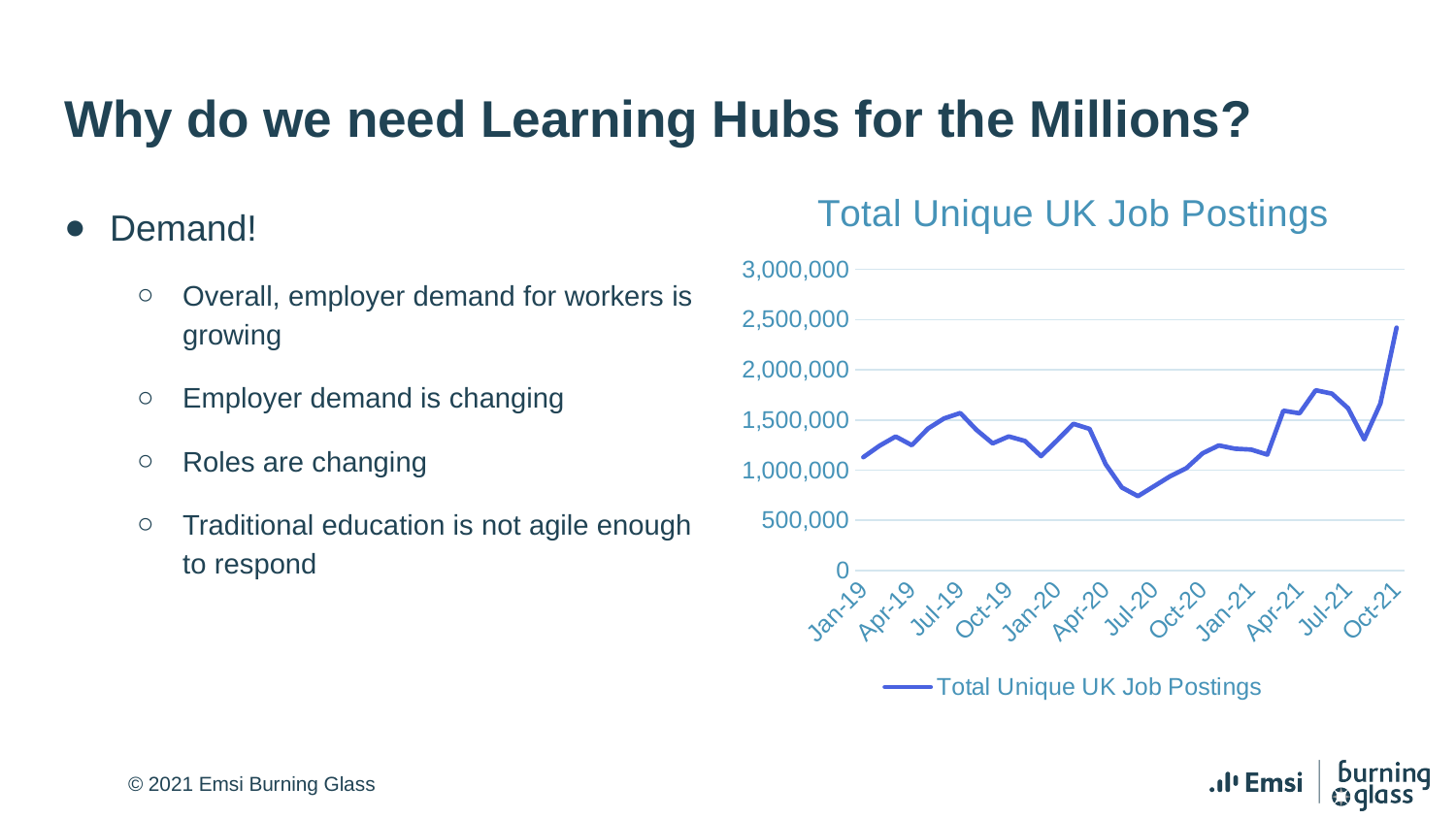
Between Jul-21 and Oct-21, does the line rise or fall? Rise What is the title of the chart on the slide? Total Unique UK Job Postings What kind of chart is shown on the slide? Line chart Is the value for Oct-21 greater or less than 2,000,000? greater Which is larger, the value for Oct-21 or the value for Jan-19? Oct-21 What is the name of the series shown in the chart's legend? Total Unique UK Job Postings Is the value for Jul-20 greater or less than 1,000,000? less At which labelled month does the line reach its highest value? Oct-21 At which labelled month does the line reach its lowest value? Jul-20 How many month labels are shown along the x axis of the chart? 12 How many series does the chart's legend list? 1 Is the value for Jul-19 greater or less than 1,000,000? greater